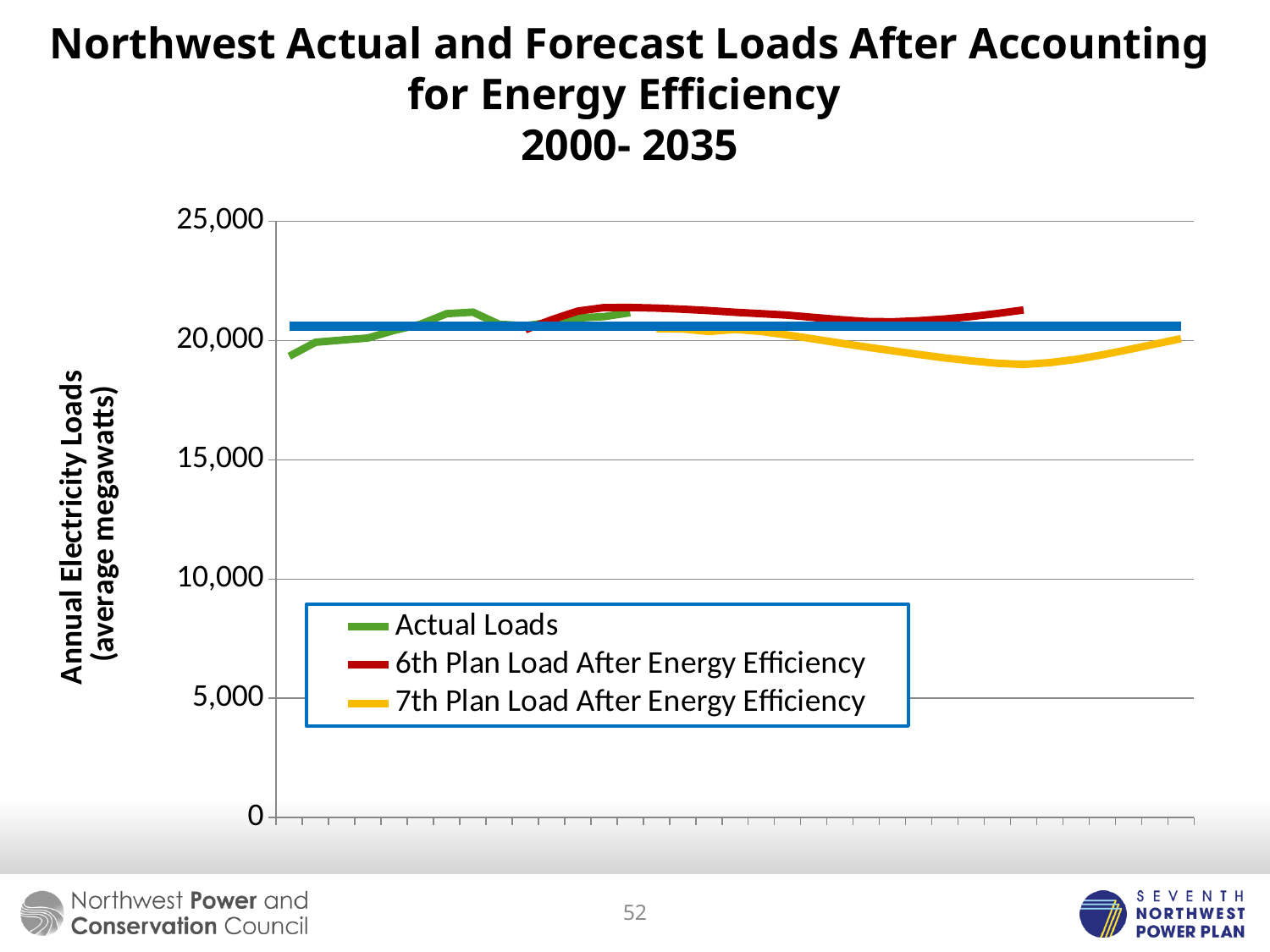
Is the lowest point of the 7th Plan Load After Energy Efficiency line greater or less than 20,000? less What is the label on the vertical axis of the chart? Annual Electricity Loads (average megawatts) What kind of chart is shown on the slide? line chart Is the starting value of the Actual Loads line greater or less than 20,000? less How many series does the legend list? 3 What is the title of the chart on the slide? Northwest Actual and Forecast Loads After Accounting for Energy Efficiency 2000- 2035 Does the Actual Loads line generally rise or fall from its start to its end? rise Is the highest point of the 6th Plan Load After Energy Efficiency line greater or less than 20,000? greater Which series has the lowest point on the chart? 7th Plan Load After Energy Efficiency Which series is higher at the right end of the chart, the 6th Plan Load After Energy Efficiency or the 7th Plan Load After Energy Efficiency? 6th Plan Load After Energy Efficiency